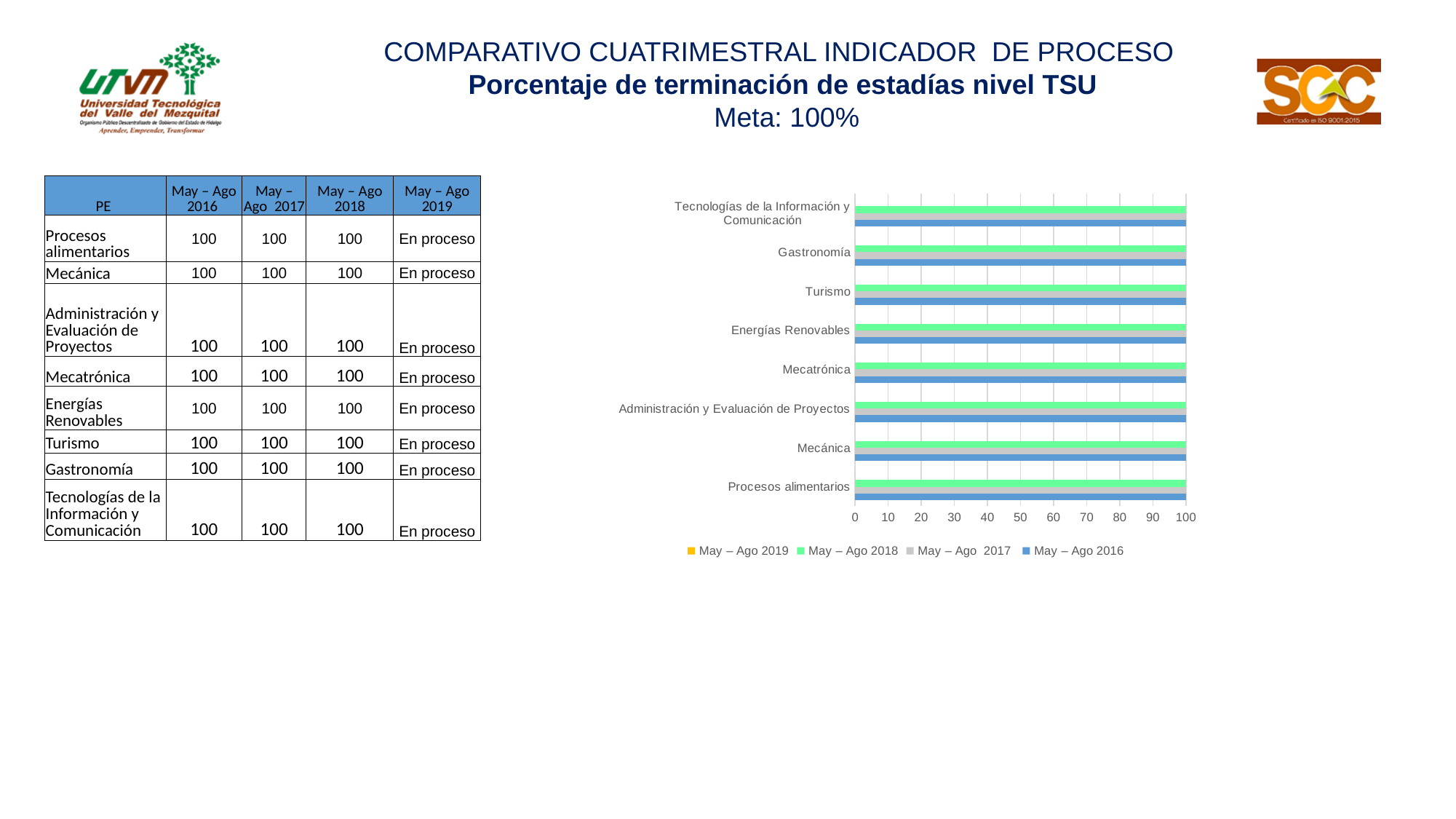
Which category appears at the bottom of the chart's vertical axis? Procesos alimentarios What is the value for Turismo in the May – Ago 2016 series? 100 What kind of chart is shown on the slide? bar chart Is the value for Energías Renovables in the May – Ago 2016 series greater or less than 50? greater Is the value for Procesos alimentarios in the May – Ago 2018 series greater or less than 90? greater What is the difference between the May – Ago 2016 value for Mecánica and the May – Ago 2016 value for Turismo? 0 What is the value for Gastronomía in the May – Ago 2018 series? 100 Which series in the legend is shown in green? May – Ago 2018 How many series does the chart legend list? 4 What is the highest value shown on the chart's horizontal axis? 100 How many categories (programas educativos) are listed on the chart's vertical axis? 8 What is the value for Mecatrónica in the May – Ago 2017 series? 100